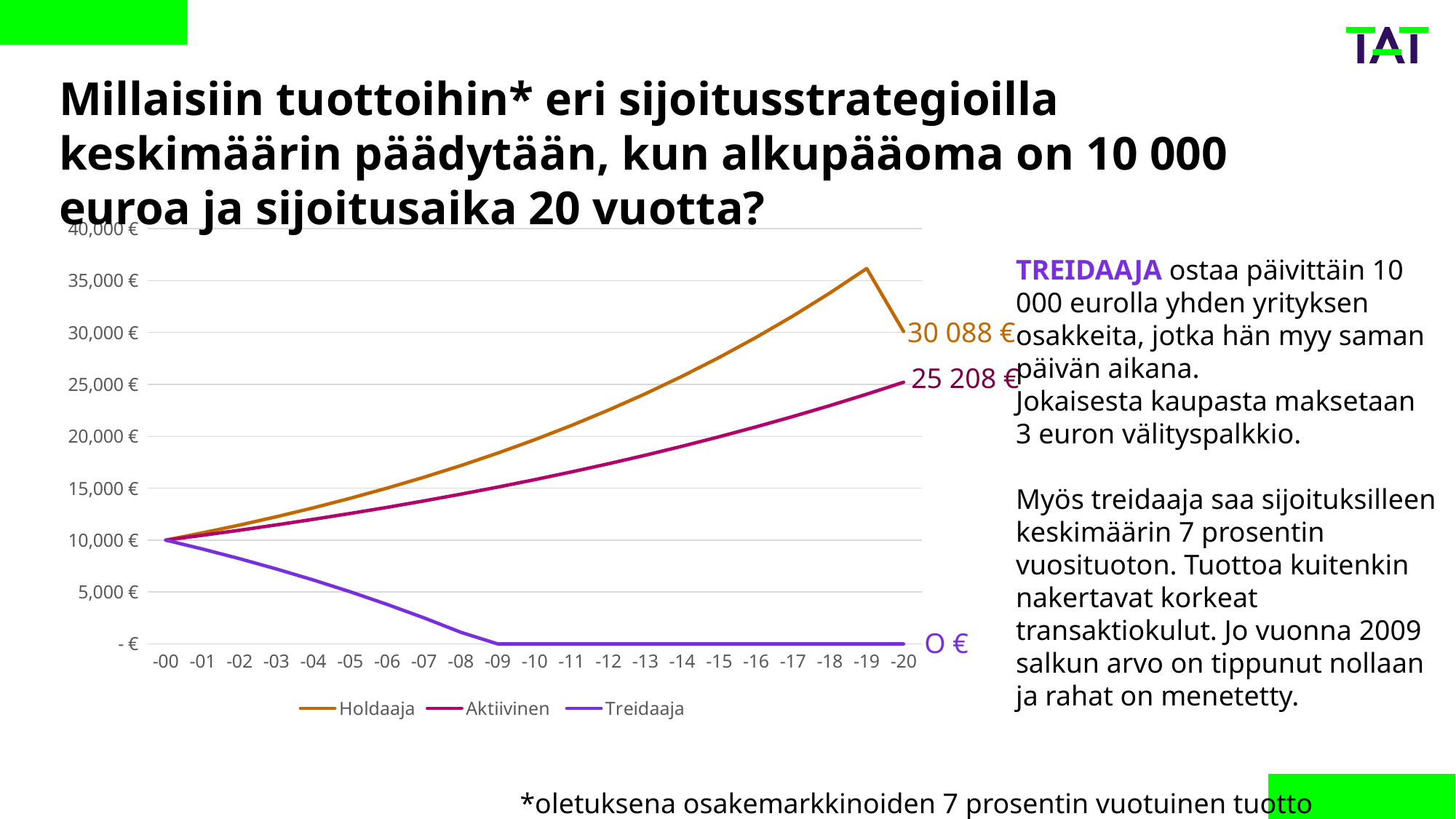
Which series has the highest value at -20? Holdaaja What is the difference between the final values of Holdaaja and Aktiivinen? 4 880 € Is the peak value of the Holdaaja series at -19 greater or less than 35,000 €? greater Which series has the lowest value at -20? Treidaaja What is the final value (at -20) for the Aktiivinen series? 25 208 € What is the final value (at -20) for the Treidaaja series? 0 € Is the final value of Aktiivinen greater or less than 25,000 €? greater What type of chart is shown on the slide? line chart How many series does the chart legend list? 3 How many year points are shown on the x axis? 21 What is the final value (at -20) for the Holdaaja series? 30 088 € Does the Treidaaja series rise or fall from -00 to -09? fall